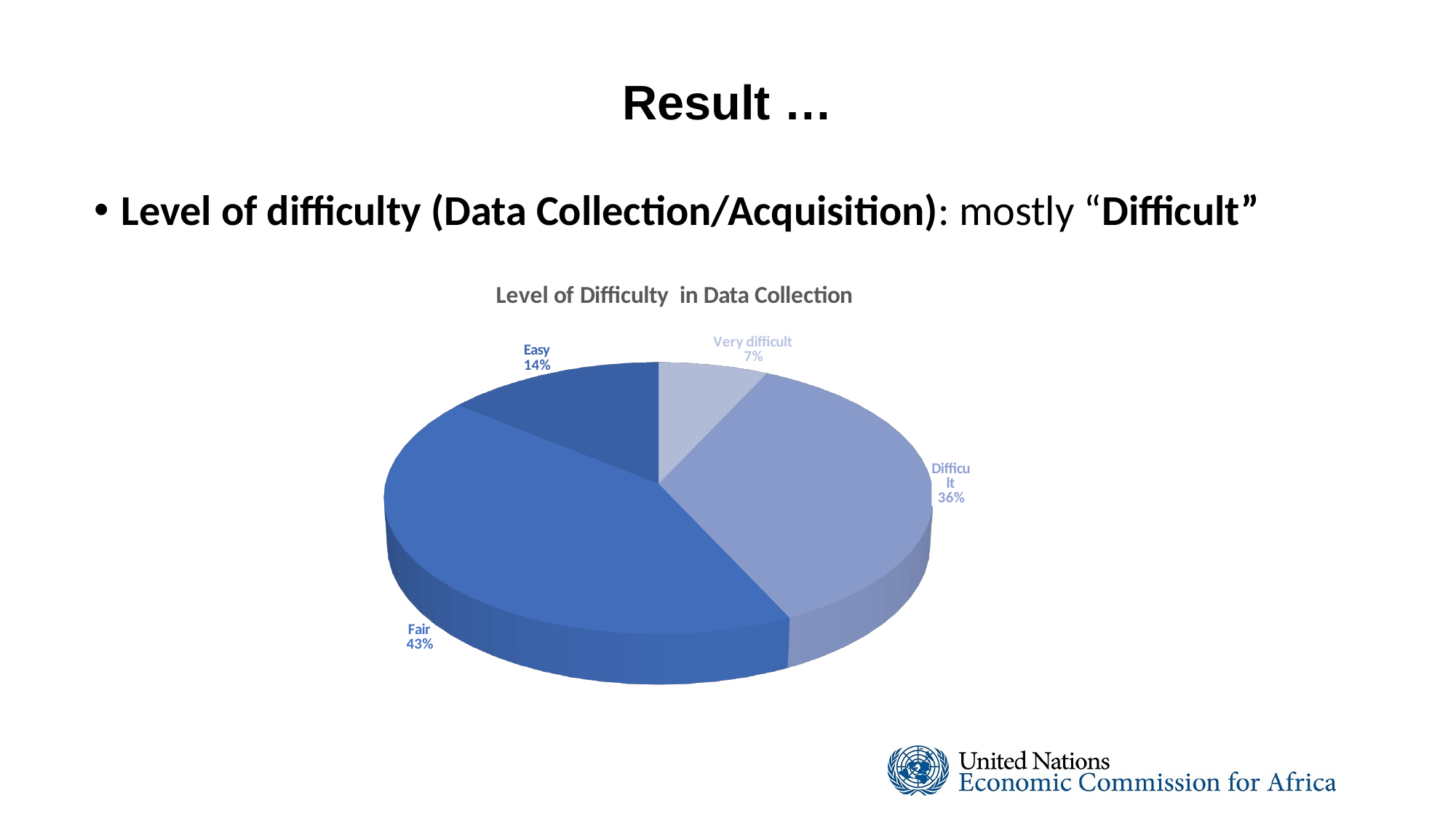
What share of the pie is labelled Fair? 43% What share of the pie is labelled Very difficult? 7% What is the title of the chart? Level of Difficulty in Data Collection Which slice is larger, Easy or Very difficult? Easy What is the difference in percentage points between the Easy and Very difficult slices? 7 Which category has the smallest share of the pie? Very difficult How many slices does the pie chart have? 4 What share of the pie is labelled Easy? 14% Which category has the largest share of the pie? Fair What is the difference in percentage points between the Fair and Difficult slices? 7 What kind of chart is shown on the slide? pie chart